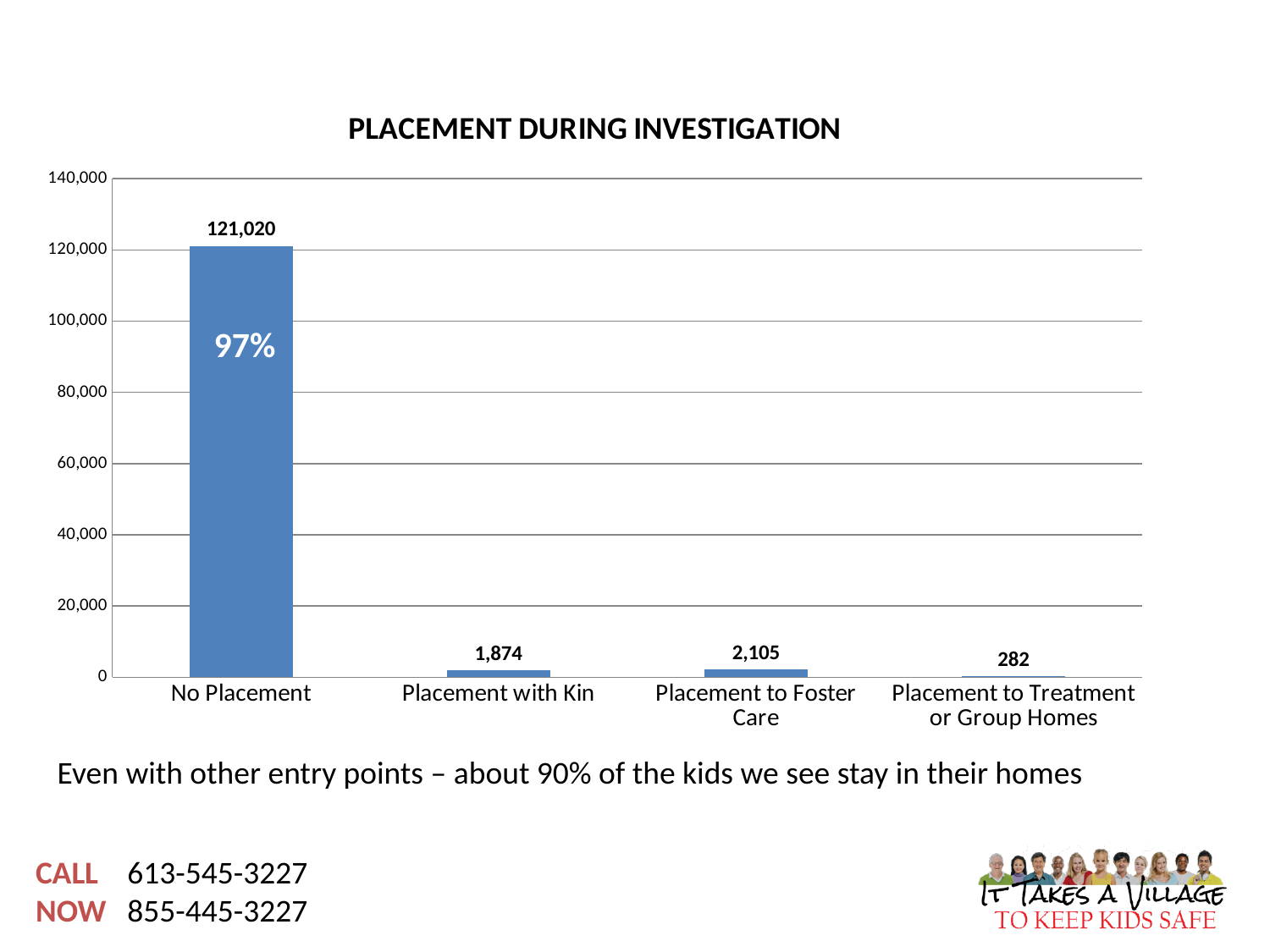
What percentage label is printed inside the No Placement bar? 97% What is the difference between Placement to Foster Care and Placement with Kin? 231 Which category has the highest value? No Placement What is the value for Placement to Foster Care? 2,105 How many categories are shown on the chart? 4 What kind of chart is this? Bar chart What is the value for Placement to Treatment or Group Homes? 282 Which is larger, Placement with Kin or Placement to Treatment or Group Homes? Placement with Kin Which category has the lowest value? Placement to Treatment or Group Homes What is the value for No Placement? 121,020 Is the value for No Placement greater or less than 100,000? greater What is the value for Placement with Kin? 1,874